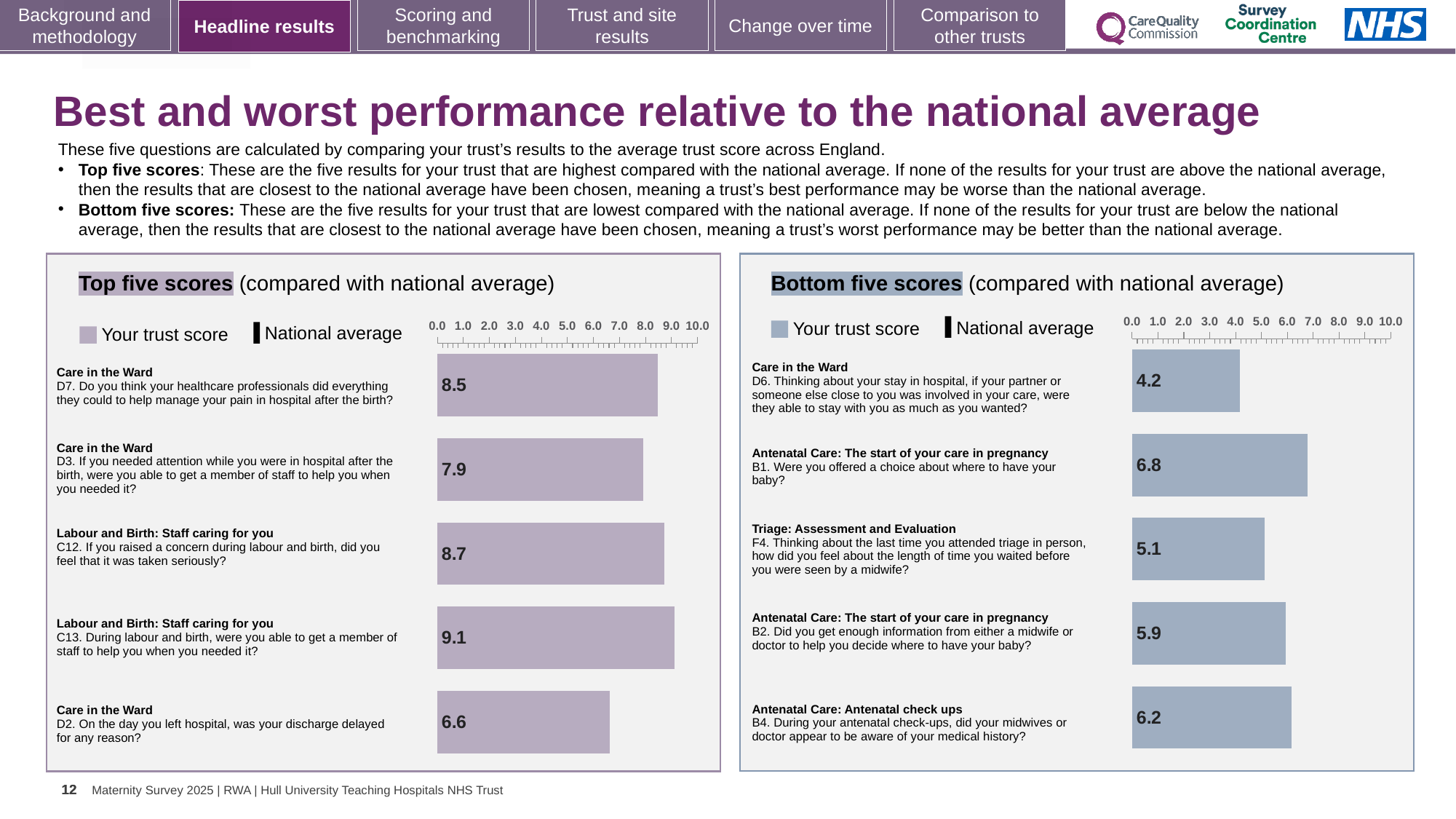
In the Bottom five scores chart, what is the trust score for question F4 about the length of time waited in triage before being seen by a midwife? 5.1 In the Top five scores chart, what is the trust score for question D7 about managing pain in hospital after the birth? 8.5 In the Top five scores chart, what is the difference between the trust scores for C13 and D2? 2.5 In the Top five scores chart, how many questions are plotted? 5 In the Bottom five scores chart, which question has the lowest trust score? D6. Thinking about your stay in hospital, if your partner or someone else close to you was involved in your care, were they able to stay with you as much as you wanted? In the Top five scores chart, which question has the lowest trust score? D2. On the day you left hospital, was your discharge delayed for any reason? In the Bottom five scores chart, what is the difference between the trust scores for B1 and D6? 2.6 What kind of chart is used in the Top five scores panel? Bar chart In the Bottom five scores chart, which has the larger trust score: B2 or B4? B4 In the Top five scores chart, which question has the highest trust score? C13. During labour and birth, were you able to get a member of staff to help you when you needed it? In the Bottom five scores chart, which question has the highest trust score? B1. Were you offered a choice about where to have your baby? How many series does the legend of the Bottom five scores chart list? 2